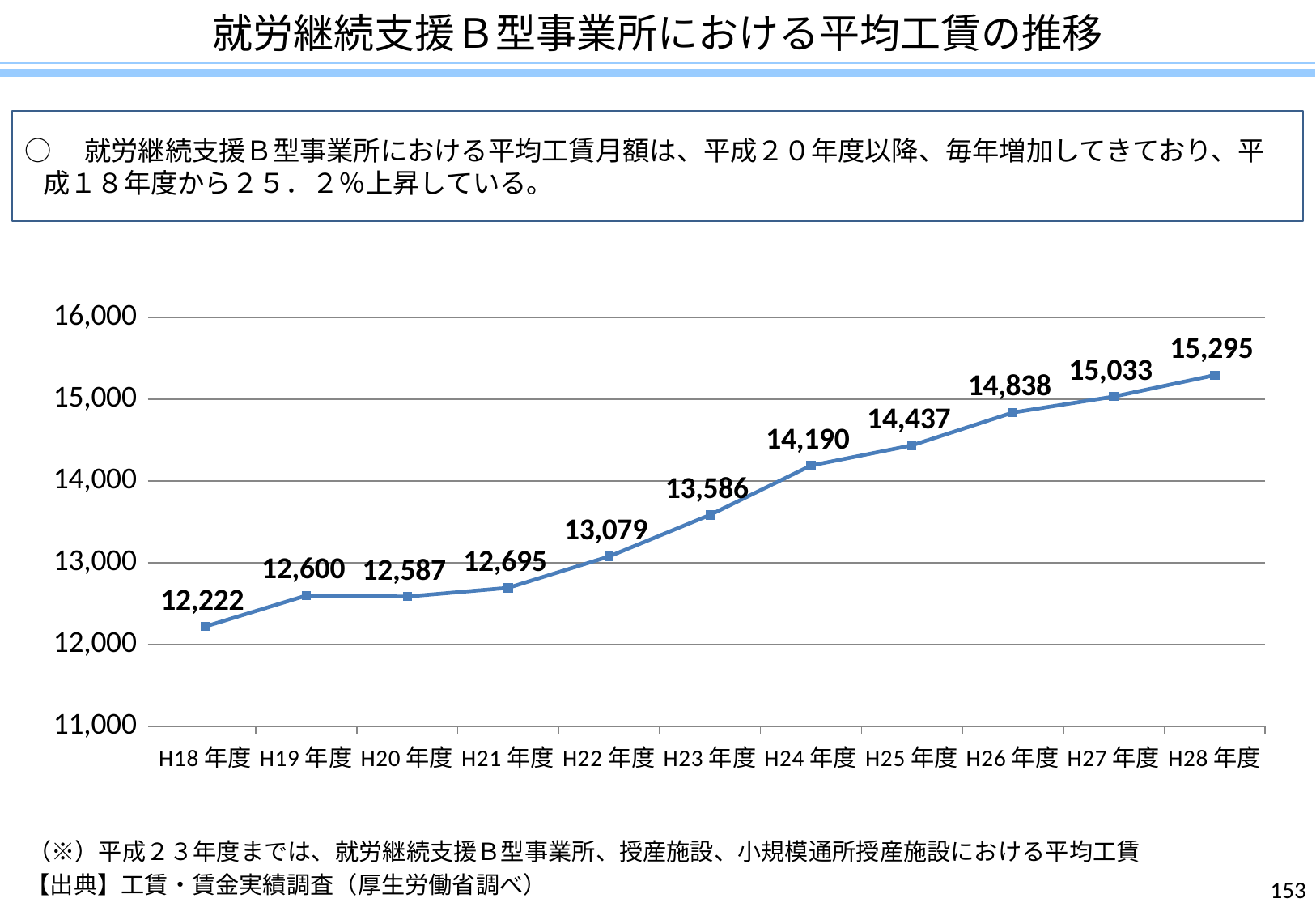
What kind of chart is shown on the slide? line chart Which year has the lowest value? H18年度 What is the value for H18年度? 12,222 How many years are plotted on the chart? 11 What is the difference between the values for H28年度 and H18年度? 3,073 Do the values generally rise or fall from H18年度 to H28年度? rise What is the difference between the values for H23年度 and H22年度? 507 What is the value for H24年度? 14,190 What is the value for H28年度? 15,295 Which year has the highest value? H28年度 Which is larger, the value for H19年度 or the value for H20年度? H19年度 Is the value for H26年度 greater or less than 15,000? less